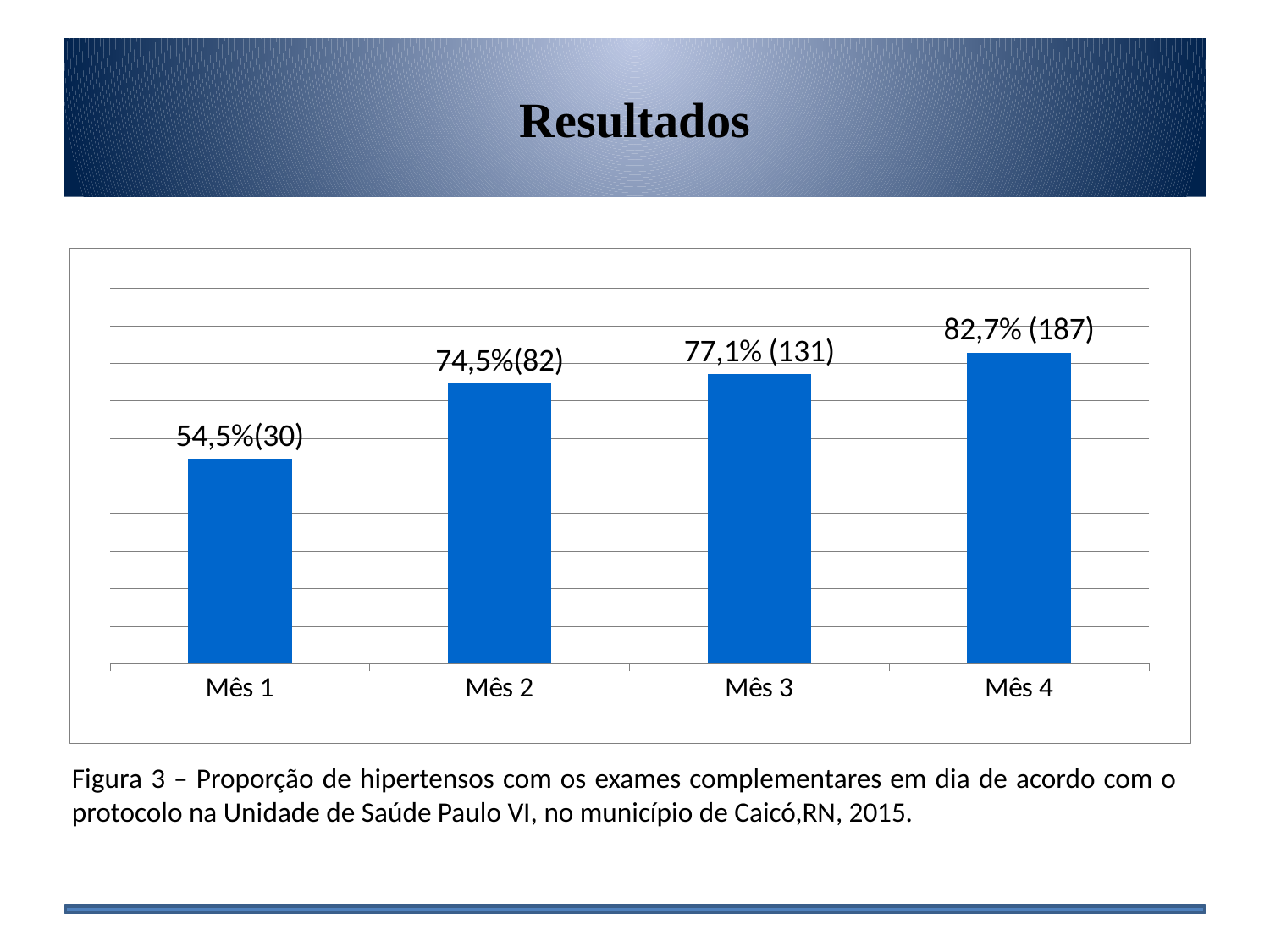
What is the difference between the counts in parentheses for Mês 4 and Mês 1? 157 What percentage is shown for Mês 4? 82,7% How many months (categories) are shown on the x axis? 4 What is the data label shown for Mês 1? 54,5%(30) What is the difference in percentage points between Mês 4 and Mês 1? 28,2 Which is larger, the value for Mês 2 or the value for Mês 3? Mês 3 What is the number in parentheses shown for Mês 3? 131 What percentage is shown for Mês 2? 74,5% Which month has the lowest bar? Mês 1 What kind of chart is shown on the slide? Bar chart Do the values rise or fall from Mês 1 to Mês 4? Rise Which month has the highest bar? Mês 4